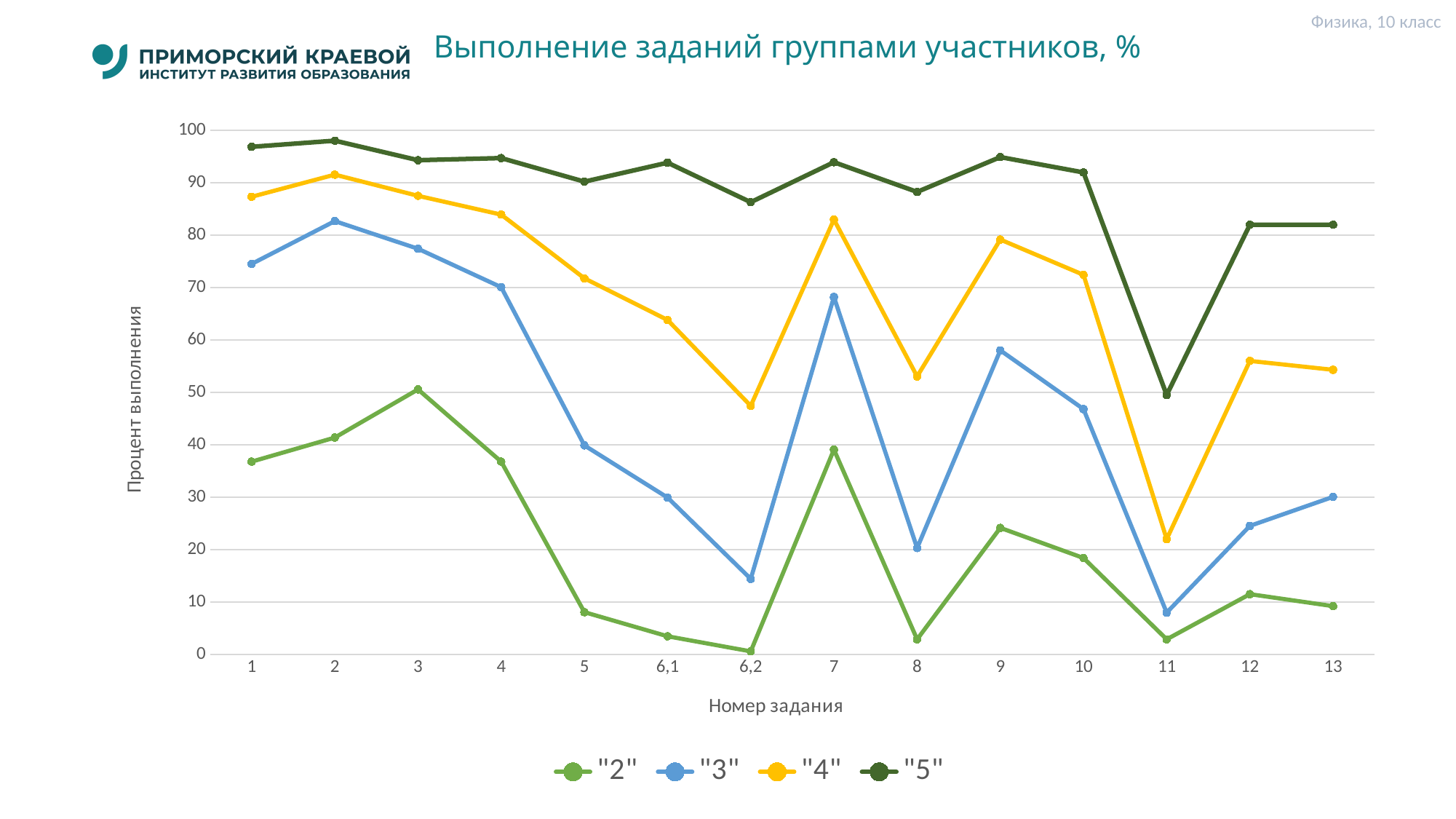
For series "5", at which task number is the value lowest? 11 For series "2", at which task number is the value highest? 3 What kind of chart is shown on the slide? line chart For series "2", at which task number is the value lowest? 6,2 How many task numbers are shown along the x axis? 14 At task 7, which series has the higher value, "3" or "4"? "4" Is the value for series "2" at task 5 greater or less than 10? less Does series "2" rise or fall from task 3 to task 6,2? fall Is the value for series "3" at task 7 greater or less than 60? greater How many series does the legend list? 4 Is the value for series "4" at task 11 greater or less than 30? less